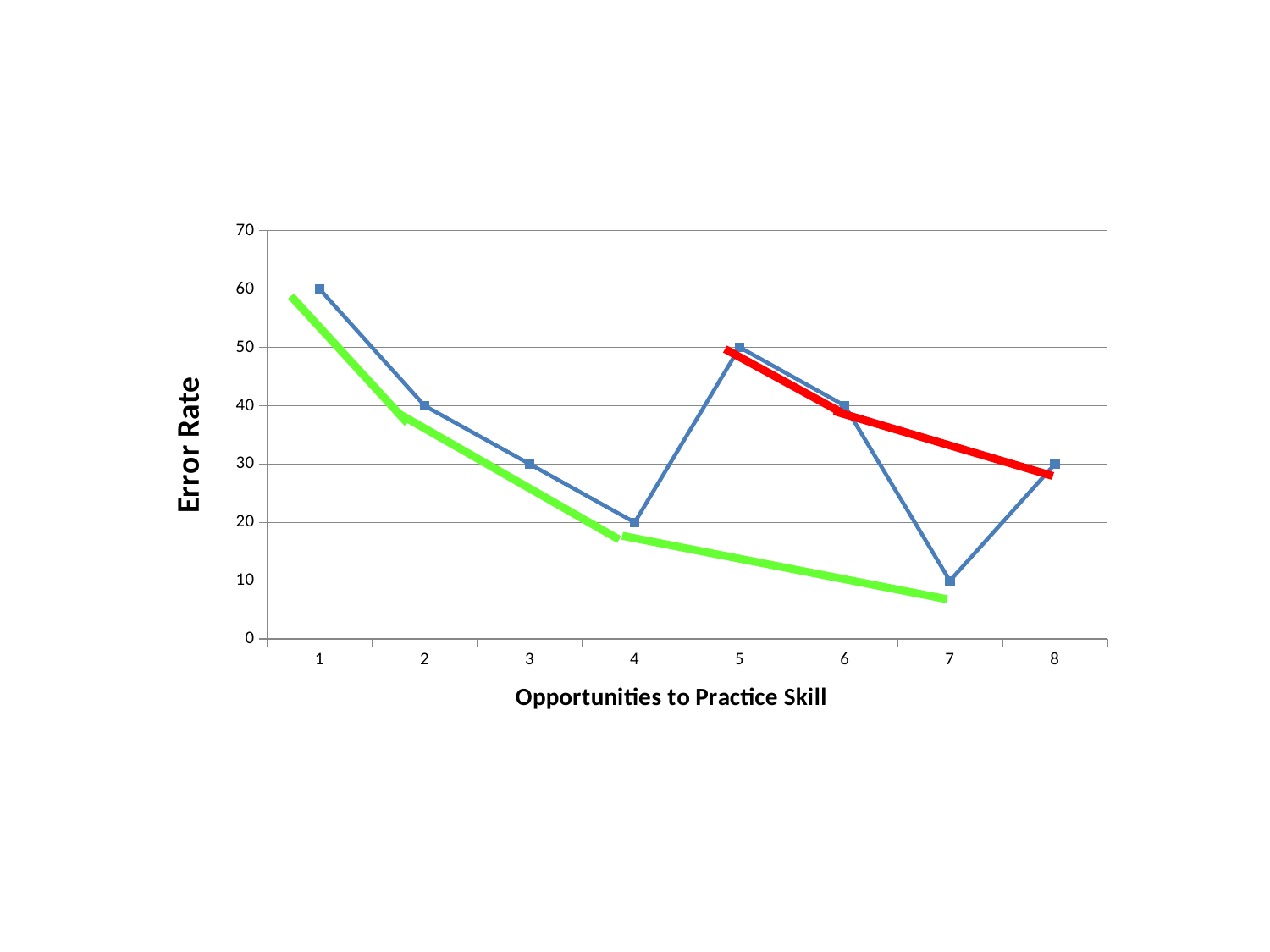
What is the label of the y axis? Error Rate Does the error rate rise or fall from opportunity 1 to opportunity 4? fall How many opportunities to practice skill are plotted on the x axis? 8 Which has a higher error rate, opportunity 5 or opportunity 8? opportunity 5 At which opportunity is the error rate lowest? 7 What is the error rate at opportunity 7? 10 What is the error rate at opportunity 4? 20 What is the error rate at opportunity 5? 50 What kind of chart is shown on the slide? line chart What is the error rate at opportunity 1? 60 At which opportunity is the error rate highest? 1 What is the difference in error rate between opportunity 1 and opportunity 4? 40